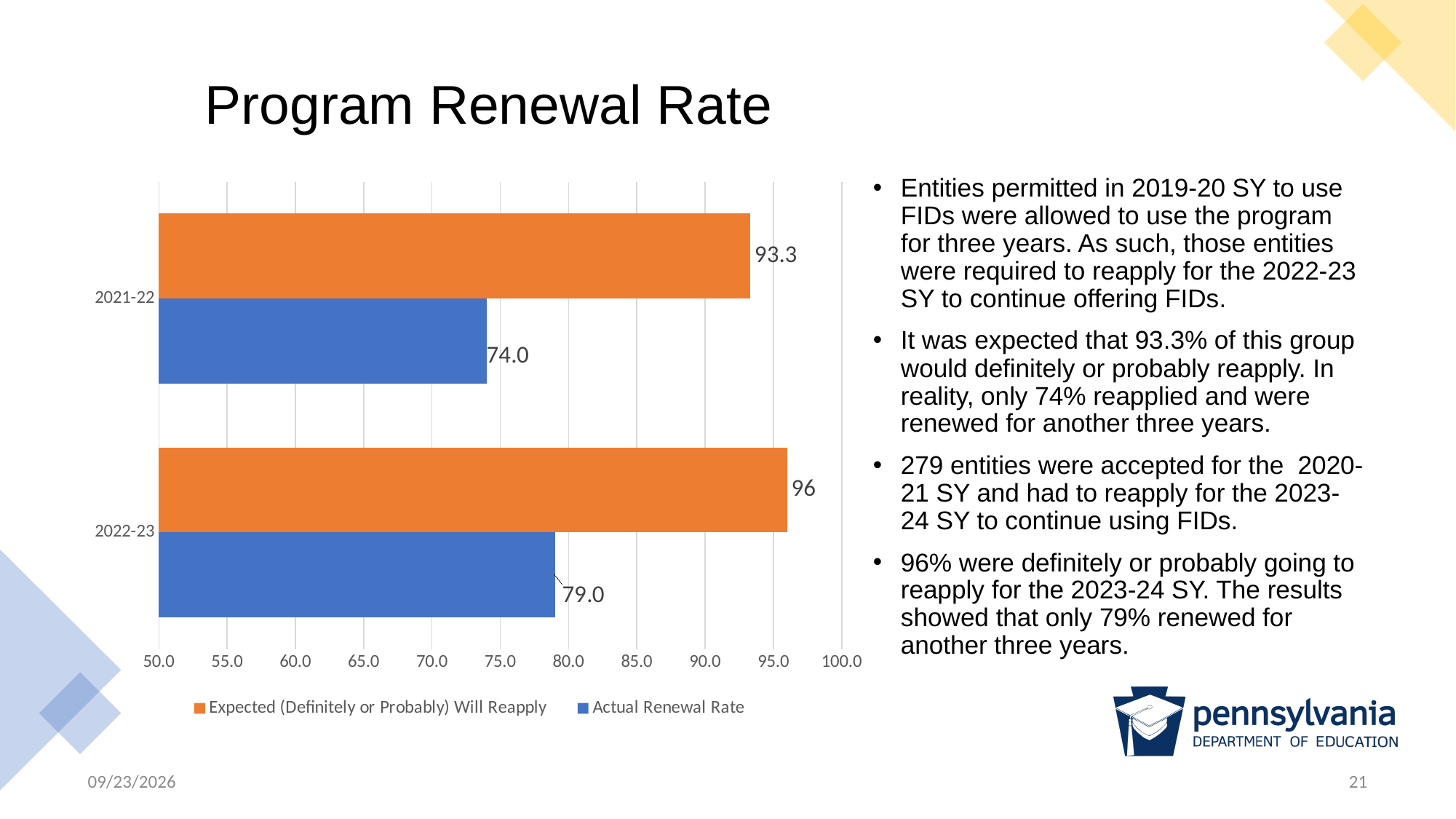
Is the Expected Will Reapply value for 2022-23 larger or smaller than the Actual Renewal Rate for 2022-23? larger What is the Expected (Definitely or Probably) Will Reapply value for 2022-23? 96 What is the difference between the Expected Will Reapply value and the Actual Renewal Rate for 2021-22? 19.3 What is the Actual Renewal Rate for 2021-22? 74.0 What type of chart is shown on the slide? bar chart How many year categories are shown on the chart? 2 What is the Expected (Definitely or Probably) Will Reapply value for 2021-22? 93.3 What is the difference between the Actual Renewal Rate for 2022-23 and for 2021-22? 5.0 How many series does the legend list? 2 Which year has the lower Expected (Definitely or Probably) Will Reapply value? 2021-22 Which year has the higher Actual Renewal Rate? 2022-23 What is the Actual Renewal Rate for 2022-23? 79.0